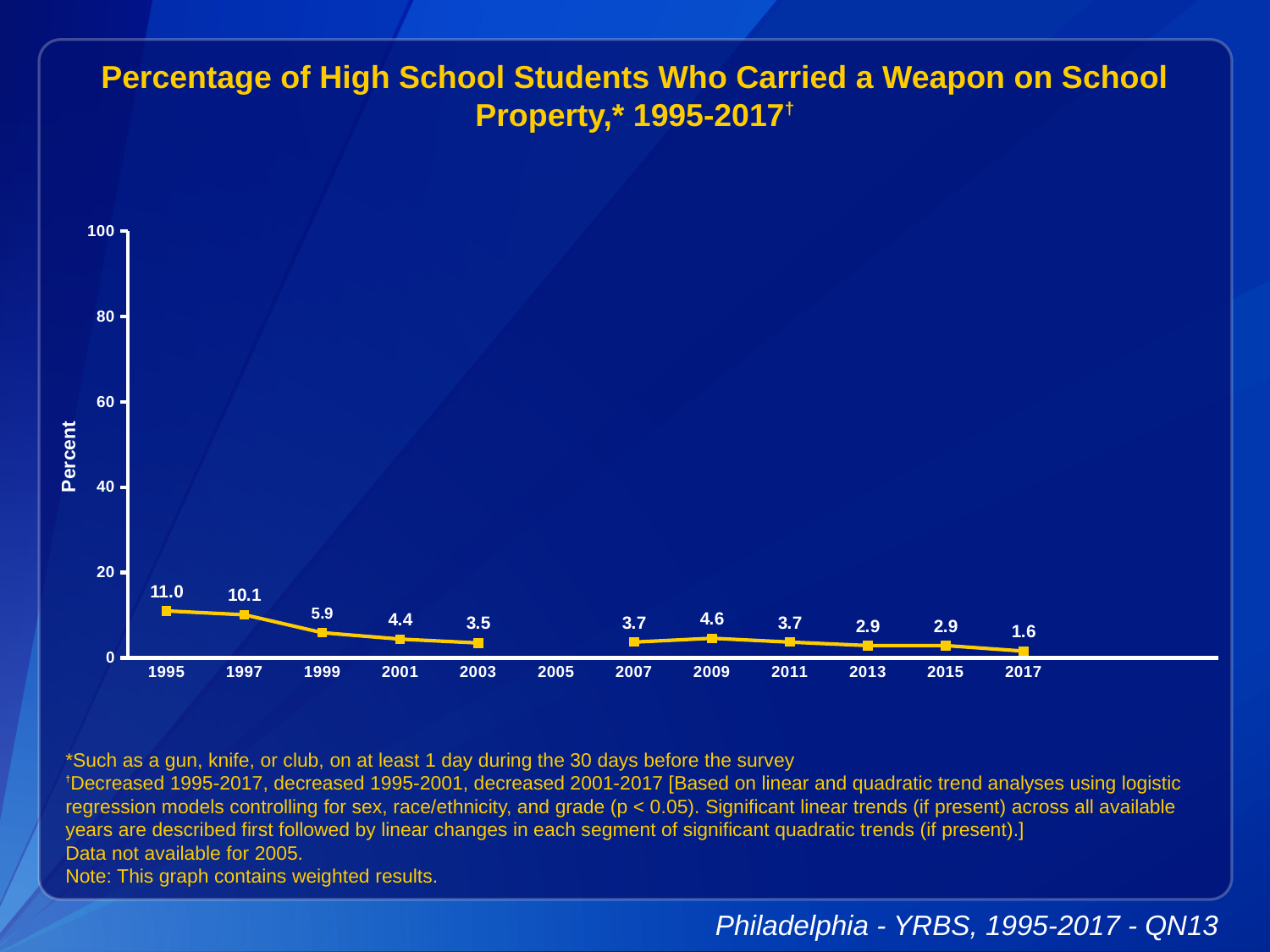
Do the values generally rise or fall from 1995 to 2017? fall How many years have data points plotted on the chart? 11 What is the value plotted for 2009? 4.6 For which year on the x axis is data not available? 2005 Which year has the highest value on the chart? 1995 What kind of chart is shown on the slide? line chart What is the value plotted for 2017? 1.6 Which year has the lowest value on the chart? 2017 Is the value for 1997 greater or less than 20? less Which year has the larger value, 1999 or 2009? 1999 What percentage of high school students carried a weapon on school property in 1995? 11.0 What is the difference between the values for 1995 and 2017? 9.4